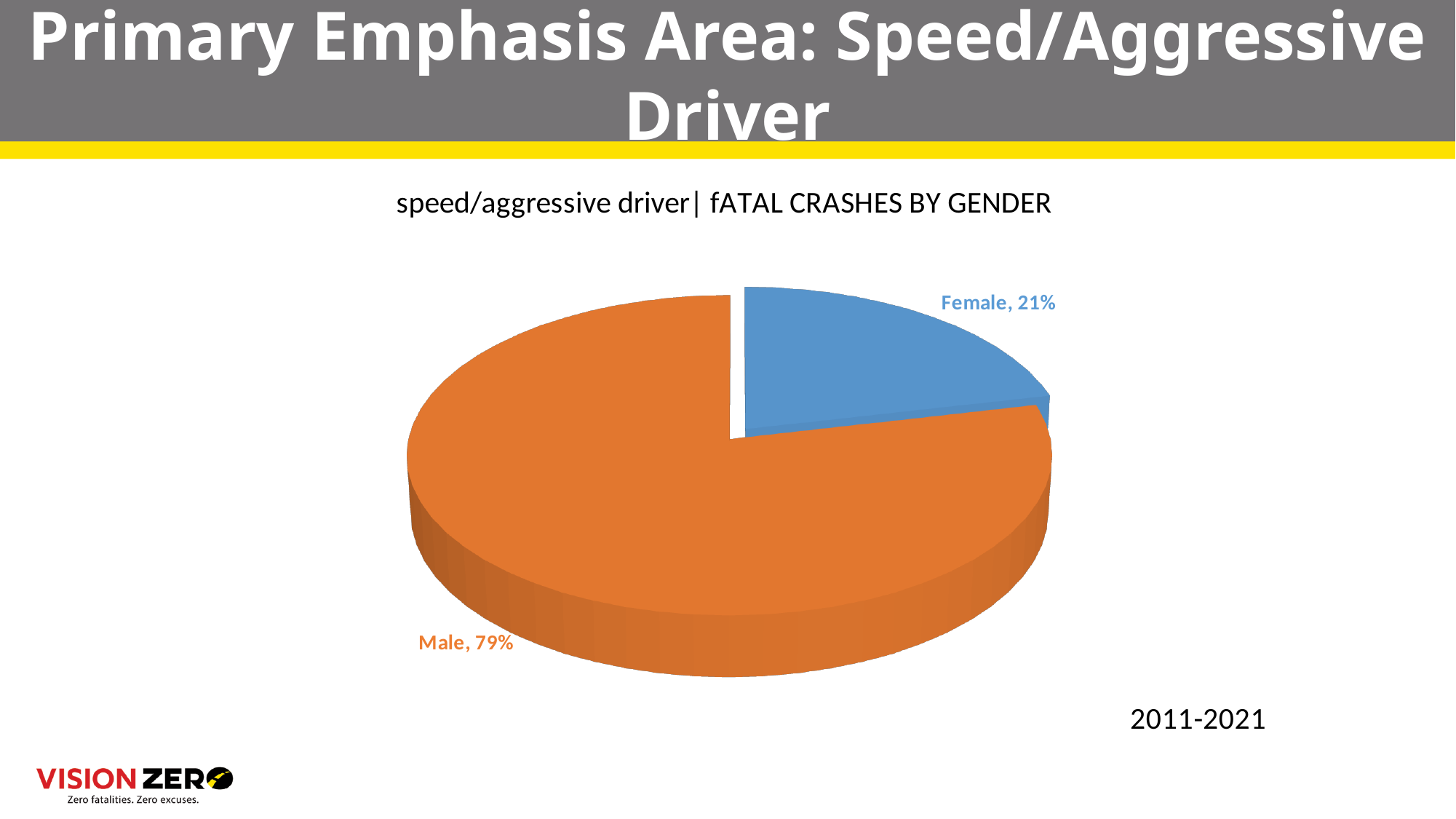
What share of speed/aggressive driver fatal crashes is attributed to Male? 79% Which gender has the smallest slice of the pie? Female What is the difference in percentage points between the Male and Female shares? 58 What kind of chart is shown on the slide? Pie chart How many slices does the pie chart have? 2 What share of speed/aggressive driver fatal crashes is attributed to Female? 21% What colour is the Female slice of the pie? Blue What is the title of the chart? speed/aggressive driver| fATAL CRASHES BY GENDER Which is larger, the Male share or the Female share? Male What time period is shown below the chart? 2011-2021 Which gender has the largest slice of the pie? Male